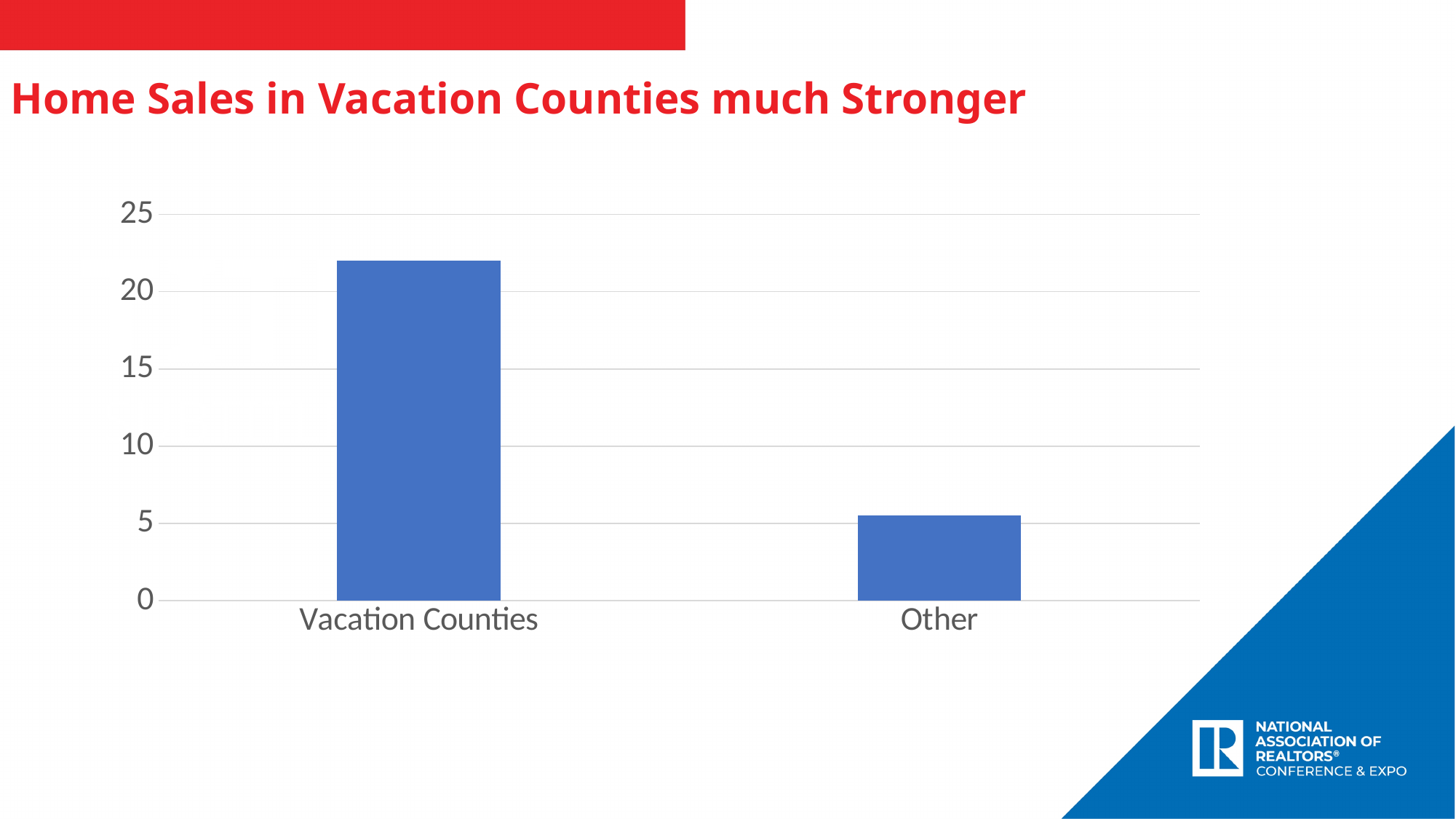
What kind of chart is shown on the slide? bar chart Is the value for Vacation Counties greater or less than 25? less Which category has the lowest value? Other Do the values rise or fall from left to right across the categories? fall How many categories are plotted in the chart? 2 Which is larger, the value for Vacation Counties or the value for Other? Vacation Counties Is the value for Other greater or less than 10? less Is the value for Vacation Counties greater or less than 20? greater Which category has the highest value? Vacation Counties What is the highest value shown on the vertical axis? 25 What is the title of the slide containing the chart? Home Sales in Vacation Counties much Stronger